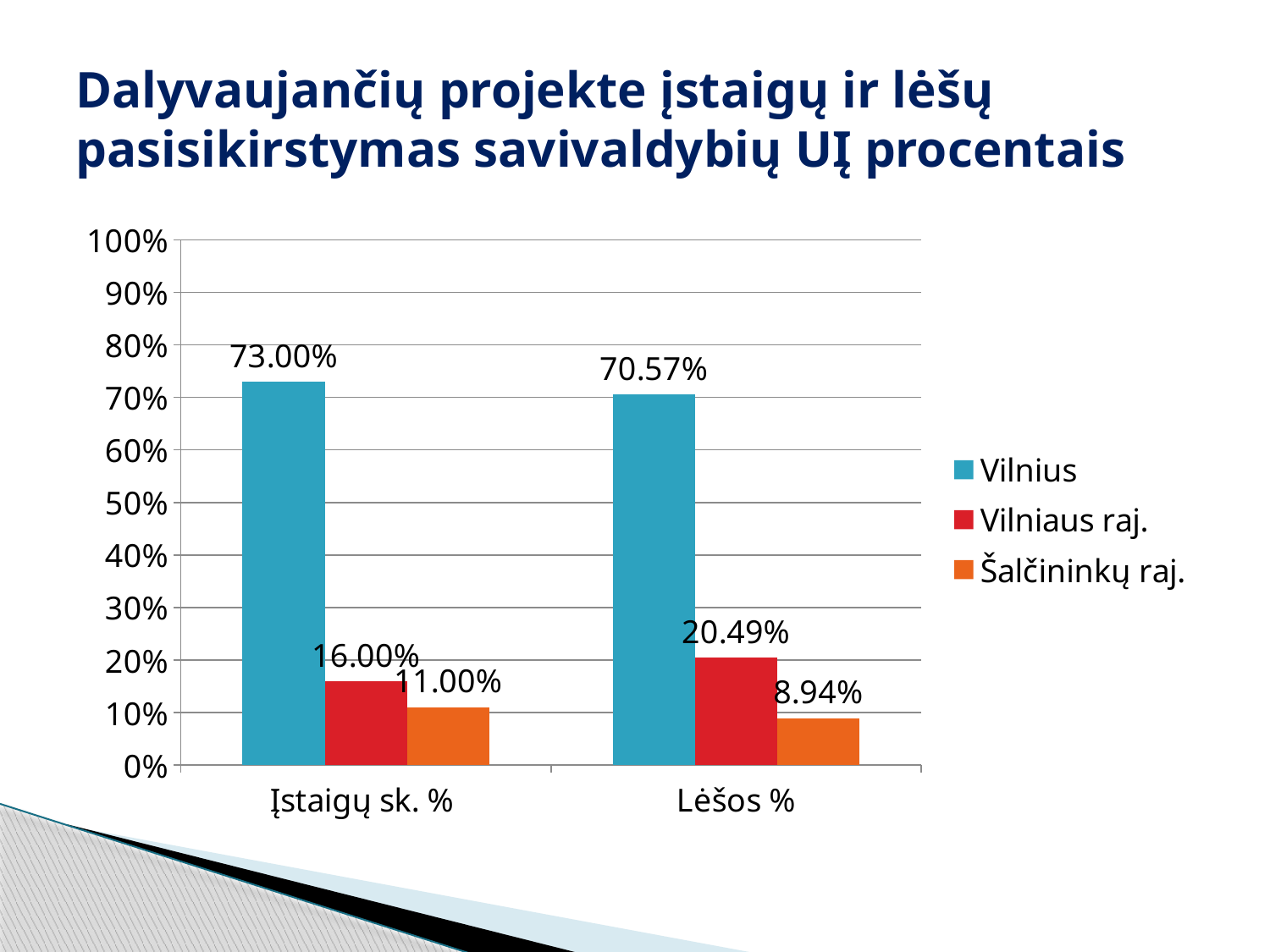
What is the value for Šalčininkų raj. in the Įstaigų sk. % category? 11.00% Which is larger: Vilniaus raj. in Įstaigų sk. % or Vilniaus raj. in Lėšos %? Vilniaus raj. in Lėšos % How many series does the legend list? 3 How many categories are shown on the x axis? 2 What is the value for Šalčininkų raj. in the Lėšos % category? 8.94% Which series has the highest value in the Lėšos % category? Vilnius What is the difference between Vilniaus raj. and Šalčininkų raj. in the Lėšos % category? 11.55% What kind of chart is shown on the slide? Bar chart What is the value for Vilniaus raj. in the Lėšos % category? 20.49% What is the value for Vilnius in the Įstaigų sk. % category? 73.00% What is the difference between the Vilnius values for Įstaigų sk. % and Lėšos %? 2.43% Which series has the lowest value in the Įstaigų sk. % category? Šalčininkų raj.